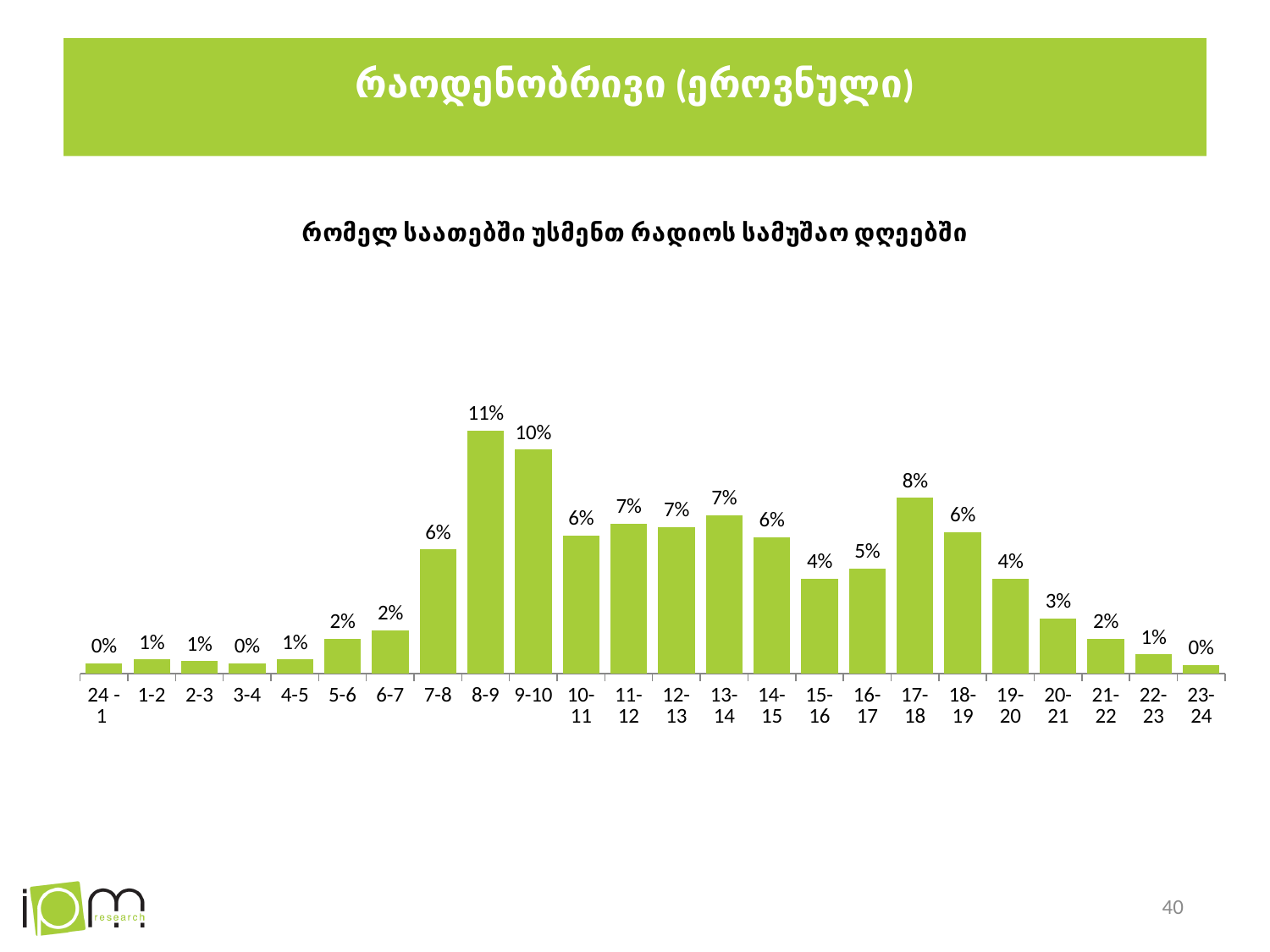
Which is larger, the value for 7-8 or the value for 16-17? 7-8 What kind of chart is shown on the slide? Bar chart How many time slots are shown on the x axis? 24 What is the value for the 20-21 time slot? 3% What is the difference between the values for 9-10 and 15-16? 6% What percentage is shown for the 8-9 time slot? 11% What percentage is shown for the 9-10 time slot? 10% What is the value for the 17-18 time slot? 8% What is the difference between the values for 8-9 and 17-18? 3% Which time slot has the highest percentage? 8-9 Do the values rise or fall from the 17-18 slot to the 23-24 slot? Fall Which is larger, the value for 17-18 or the value for 13-14? 17-18